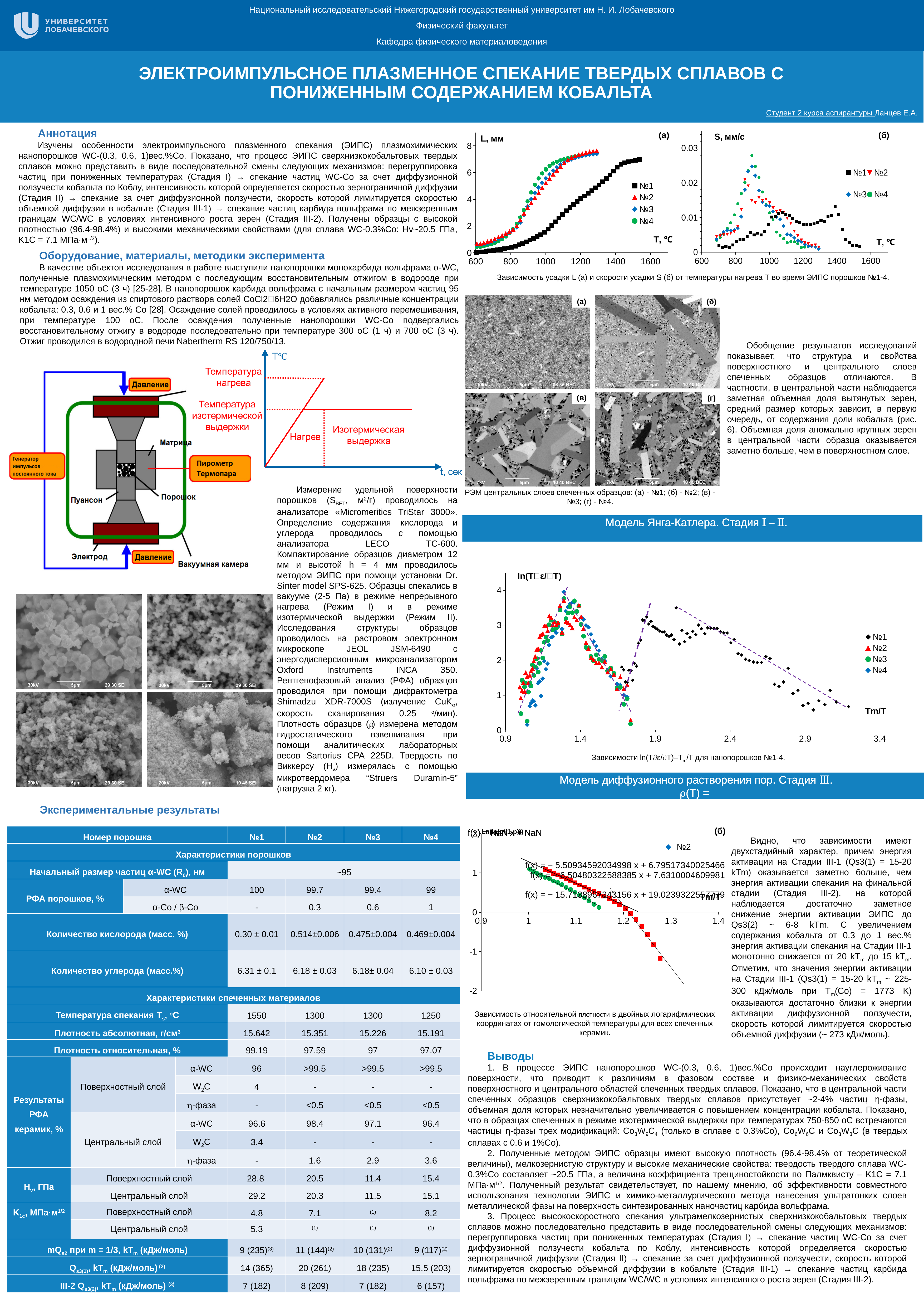
In the 'L, мм' chart (panel (а)), do the values for series №1 rise or fall as temperature increases along the x axis? rise In the 'ln(T∂ε/∂T)' versus 'Tm/T' chart, how many series does the legend list? 4 In the 'L, мм' chart (panel (а)), what is the highest tick value shown on the y axis? 8 What kind of chart is the 'ln(T∂ε/∂T)' versus 'Tm/T' chart? scatter chart In the 'L, мм' chart (panel (а)), is the value for series №1 at 1400 °C greater or less than 4? greater In the 'ln(T∂ε/∂T)' versus 'Tm/T' chart, is the value for series №1 at Tm/T = 2.9 greater or less than 2? less In the 'S, мм/с' chart (panel (б), top right), how many series does the legend list? 4 In the chart titled 'L, мм' (top right, panel (а)), how many series does the legend list? 4 What kind of chart is the 'L, мм' versus 'T, °C' chart (panel (а))? scatter chart In the 'S, мм/с' chart (panel (б), top right), what is the highest tick value shown on the y axis? 0.03 In the 'ln(T∂ε/∂T)' versus 'Tm/T' chart, do the values for series №1 rise or fall as Tm/T increases from 2.4 to 3.4? fall In the 'L, мм' chart (panel (а)), is the value for series №2 at 800 °C greater or less than 4? less